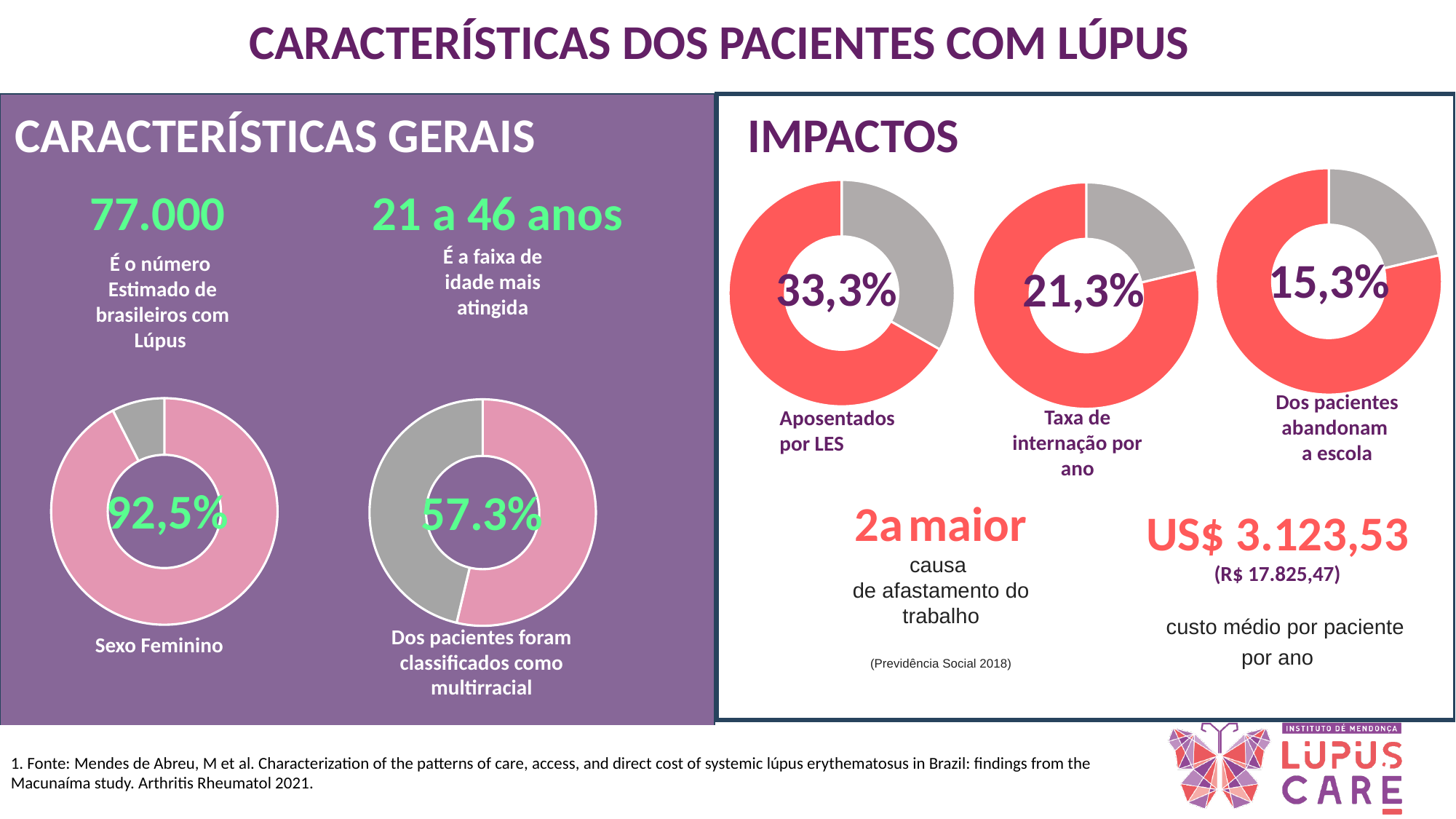
In the IMPACTOS section, what percentage is shown in the 'Taxa de internação por ano' donut chart? 21,3% Which is larger: the percentage in the 'Sexo Feminino' chart or the percentage in the multirracial chart? Sexo Feminino What kind of chart is used to show the 'Sexo Feminino' percentage? Donut (pie) chart Among the three donut charts in the IMPACTOS section, which one shows the lowest percentage? Dos pacientes abandonam a escola What colour is the highlighted slice in the donut charts of the IMPACTOS section? Red Among the three donut charts in the IMPACTOS section, which one shows the highest percentage? Aposentados por LES In the IMPACTOS section, what percentage is shown in the donut chart labelled 'Dos pacientes abandonam a escola'? 15,3% In the IMPACTOS section, what percentage is shown in the 'Aposentados por LES' donut chart? 33,3% What percentage is shown in the 'Sexo Feminino' donut chart? 92,5% How many donut charts are shown on the slide in total? 5 What percentage is shown in the donut chart labelled 'Dos pacientes foram classificados como multirracial'? 57.3% What is the difference in percentage points between the 'Aposentados por LES' chart and the 'Taxa de internação por ano' chart? 12 percentage points